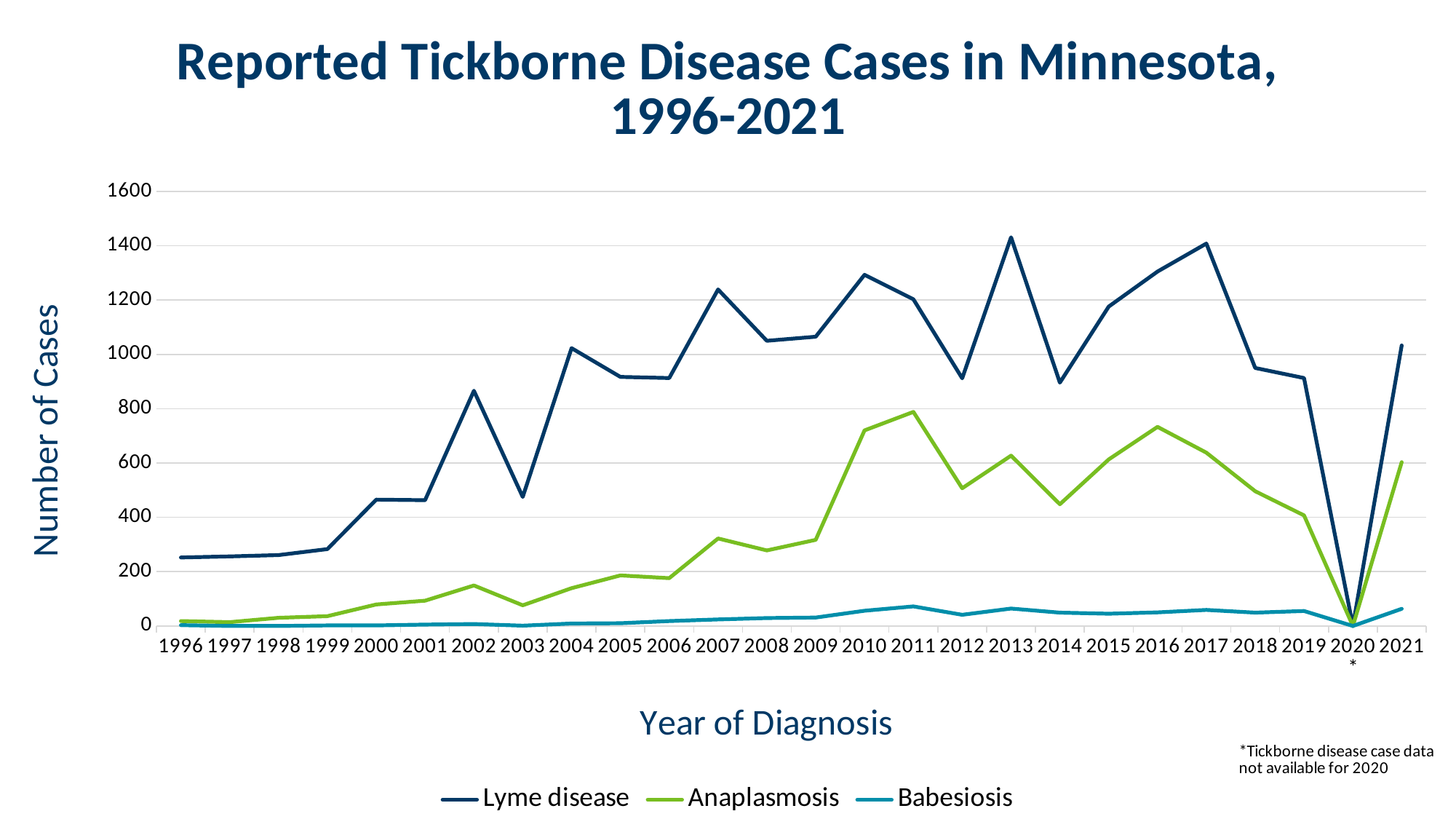
How many series does the legend list? 3 Is the value for Lyme disease in 2003 greater or less than 600? less How many years are shown along the x axis? 26 Which is larger, the Lyme disease value in 2004 or in 2003? 2004 According to the footnote, for which year is tickborne disease case data not available? 2020 In which year does the Anaplasmosis line reach its highest point? 2011 Does the Anaplasmosis line rise or fall from 2016 to 2019? fall In which year does the Lyme disease line drop to its lowest point? 2020 Which series has the highest number of cases in 2017? Lyme disease Is the value for Anaplasmosis in 2010 greater or less than 600? greater Is the value for Lyme disease in 2010 greater or less than 1200? greater What kind of chart is shown on the slide? Line chart